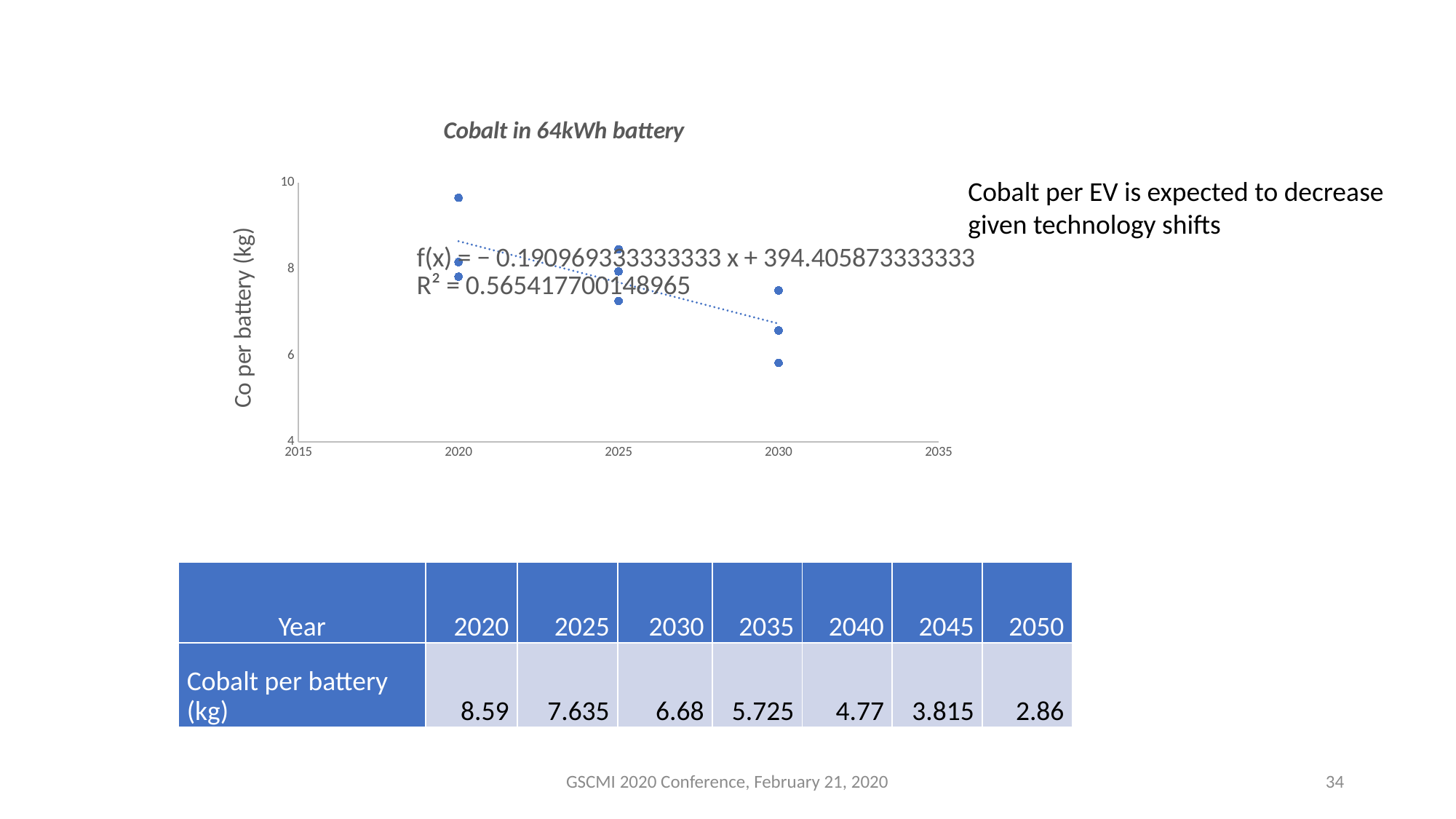
At how many distinct years are data points plotted on the chart? 3 Which year has the highest single plotted point on the chart? 2020 Is the lowest plotted value for 2025 greater or less than 7? greater What is the title of the chart? Cobalt in 64kWh battery Is the lowest plotted value for 2030 greater or less than 6? less Is the highest plotted value for 2020 greater or less than 9? greater How many data points are plotted on the chart? 9 What is the label on the vertical axis of the chart? Co per battery (kg) Which year has the lowest single plotted point on the chart? 2030 What kind of chart is shown on the slide? Scatter chart Do the plotted values generally rise or fall as the year increases along the x axis? Fall